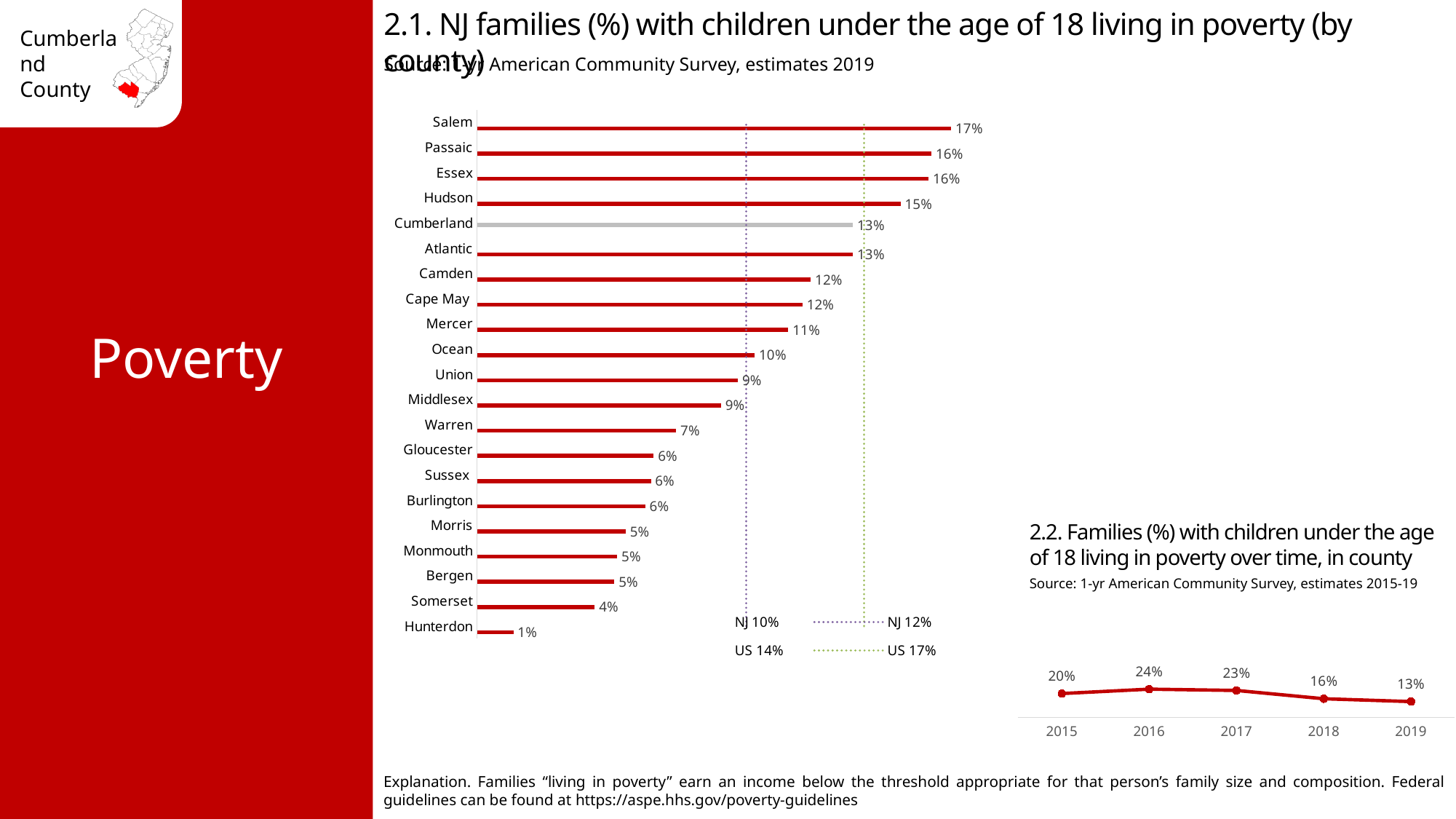
In chart 2.2 (over time, in county), which year has the lowest value? 2019 In chart 2.1 (by county), which county has the lowest percentage? Hunterdon In chart 2.2 (families in poverty over time, in county), what is the value for 2016? 24% In chart 2.1 (by county), what is the value for Mercer? 11% In chart 2.2 (over time, in county), what is the difference between the 2016 and 2019 values? 11% In chart 2.1 (by county), what is the difference between the values for Salem and Hunterdon? 16% What kind of chart is chart 2.1 (by county)? Bar chart In chart 2.1 (NJ families with children under 18 living in poverty by county), what is the value for Cumberland? 13% In chart 2.1 (by county), which has a higher value, Hudson or Camden? Hudson How many counties are shown in chart 2.1 (by county)? 21 In chart 2.1 (by county), which county has the highest percentage of families with children living in poverty? Salem